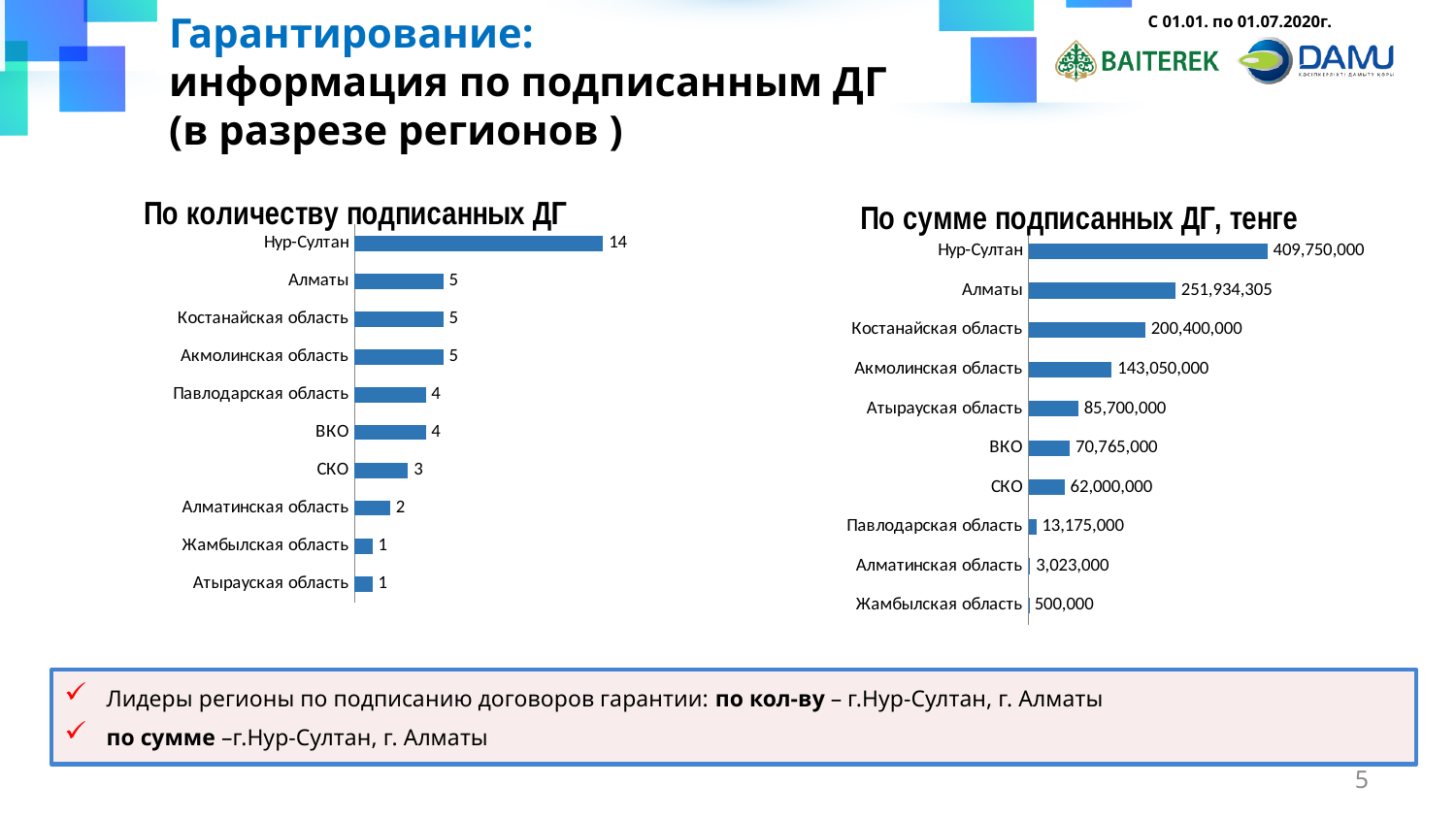
In the chart 'По количеству подписанных ДГ', what is the difference between Нур-Султан and Алматы? 9 In the chart 'По количеству подписанных ДГ', how many regions are shown? 10 In the chart 'По сумме подписанных ДГ, тенге', what is the difference between Нур-Султан and Костанайская область? 209,350,000 In the chart 'По количеству подписанных ДГ', which region has the highest value? Нур-Султан In the chart 'По сумме подписанных ДГ, тенге', which region has the lowest value? Жамбылская область In the chart 'По количеству подписанных ДГ', what is the value for Нур-Султан? 14 In the chart 'По сумме подписанных ДГ, тенге', what is the value for Павлодарская область? 13,175,000 In the chart 'По сумме подписанных ДГ, тенге', which is larger: Атырауская область or ВКО? Атырауская область In the chart 'По сумме подписанных ДГ, тенге', what is the value for Алматы? 251,934,305 In the chart 'По сумме подписанных ДГ, тенге', how many regions are shown? 10 What type of chart is 'По сумме подписанных ДГ, тенге'? Bar chart In the chart 'По количеству подписанных ДГ', what is the value for СКО? 3